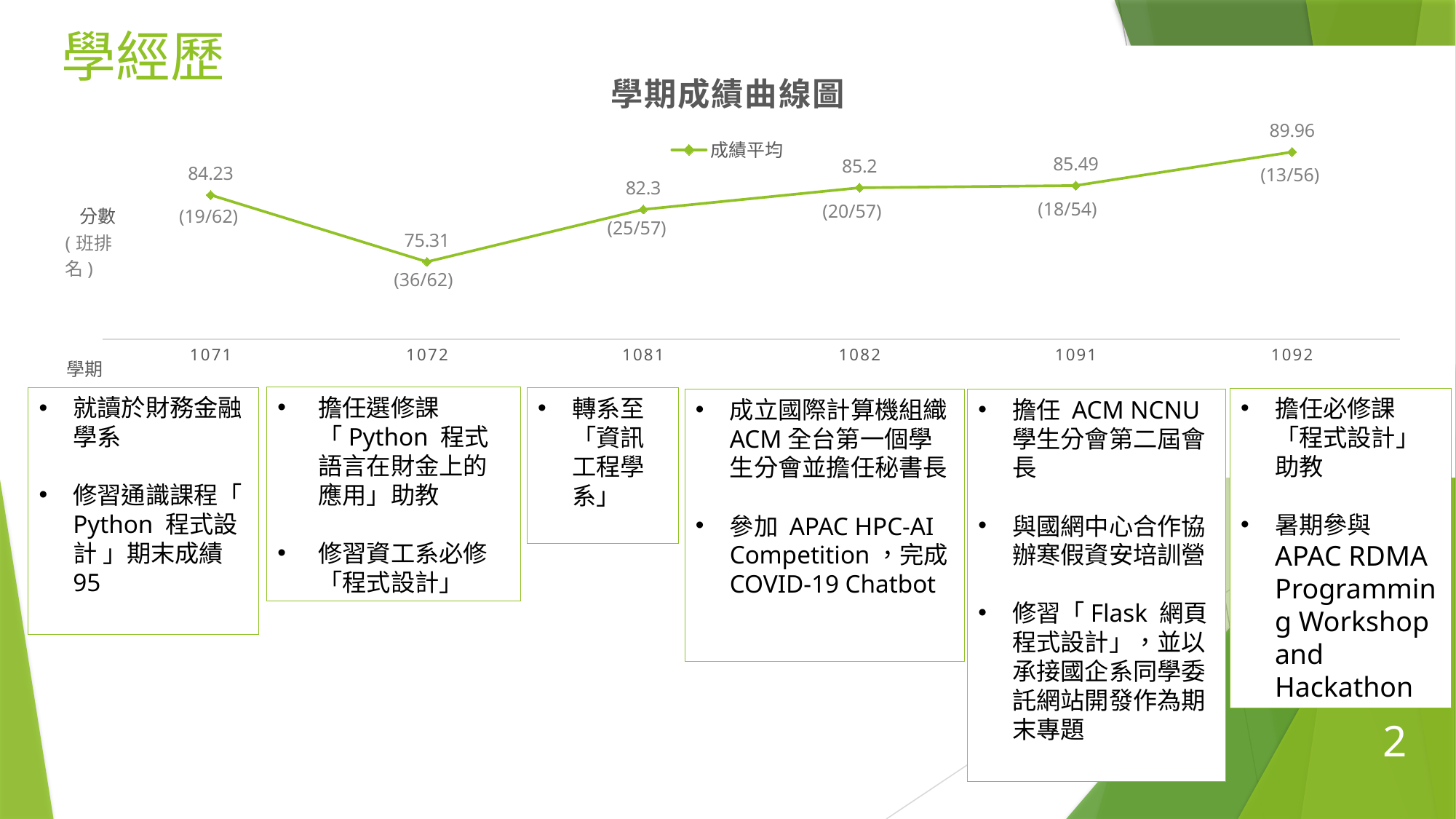
Which semester has a higher 成績平均, 1071 or 1081? 1071 How many series does the legend list? 1 Which semester has the highest 成績平均? 1092 What is the 成績平均 value for semester 1071? 84.23 Which semester has the lowest 成績平均? 1072 What is the title of the chart? 學期成績曲線圖 What is the difference between the 成績平均 for 1092 and 1072? 14.65 What is the 成績平均 value for semester 1092? 89.96 How many semesters are plotted on the chart? 6 What kind of chart is shown on the slide? line chart What is the 成績平均 value for semester 1082? 85.2 What is the 成績平均 value for semester 1072? 75.31